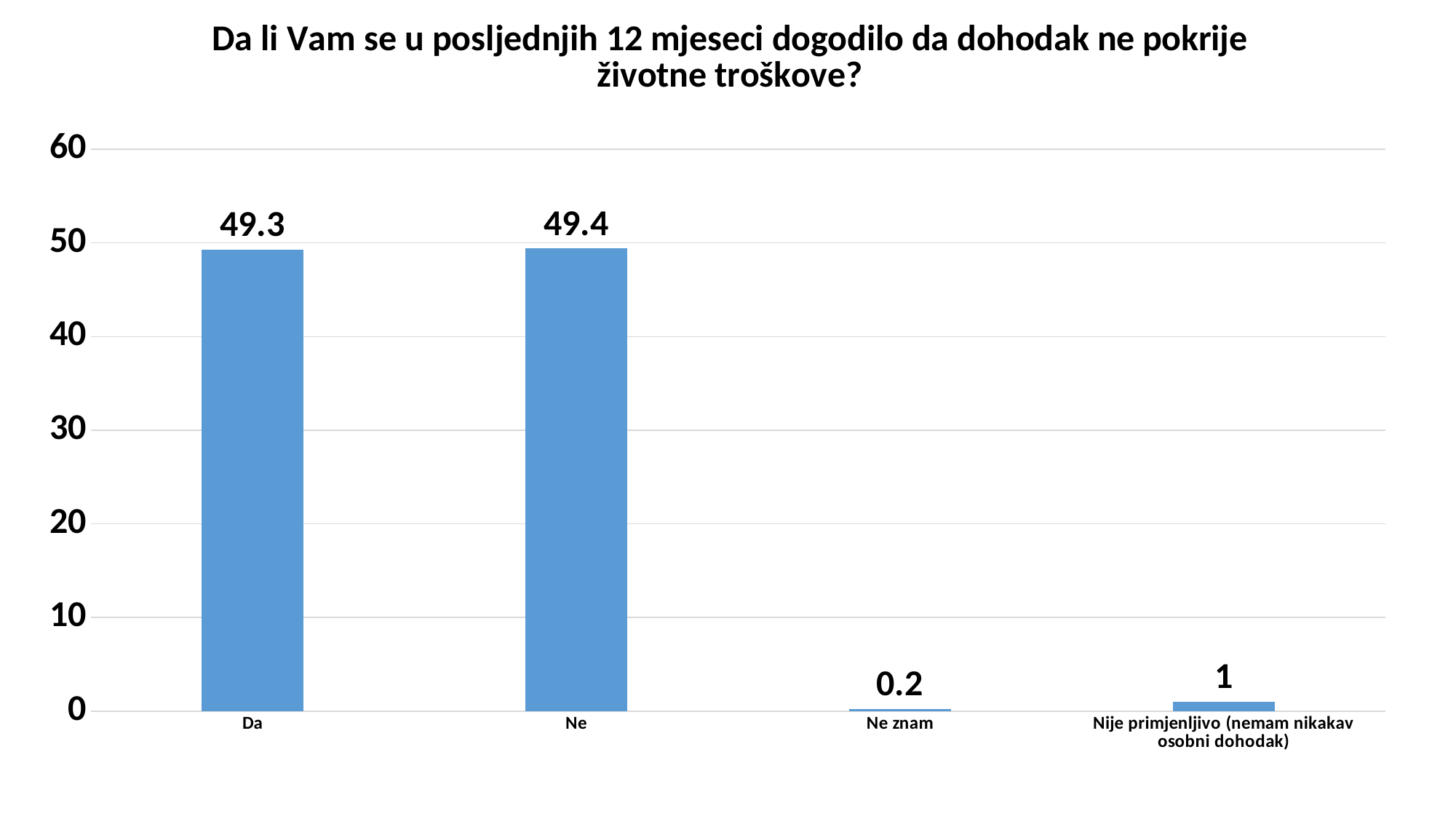
Which category has the lowest value? Ne znam What is the value for "Da"? 49.3 How many categories are shown on the x axis? 4 What is the difference between the values for "Nije primjenljivo (nemam nikakav osobni dohodak)" and "Ne znam"? 0.8 What is the difference between the values for "Ne" and "Da"? 0.1 What is the value for "Nije primjenljivo (nemam nikakav osobni dohodak)"? 1 Is the value for "Da" greater or less than 40? greater What is the value for "Ne"? 49.4 Which is larger, the value for "Ne znam" or the value for "Nije primjenljivo (nemam nikakav osobni dohodak)"? Nije primjenljivo (nemam nikakav osobni dohodak) What kind of chart is shown on the slide? bar chart What is the value for "Ne znam"? 0.2 Which category has the highest value? Ne